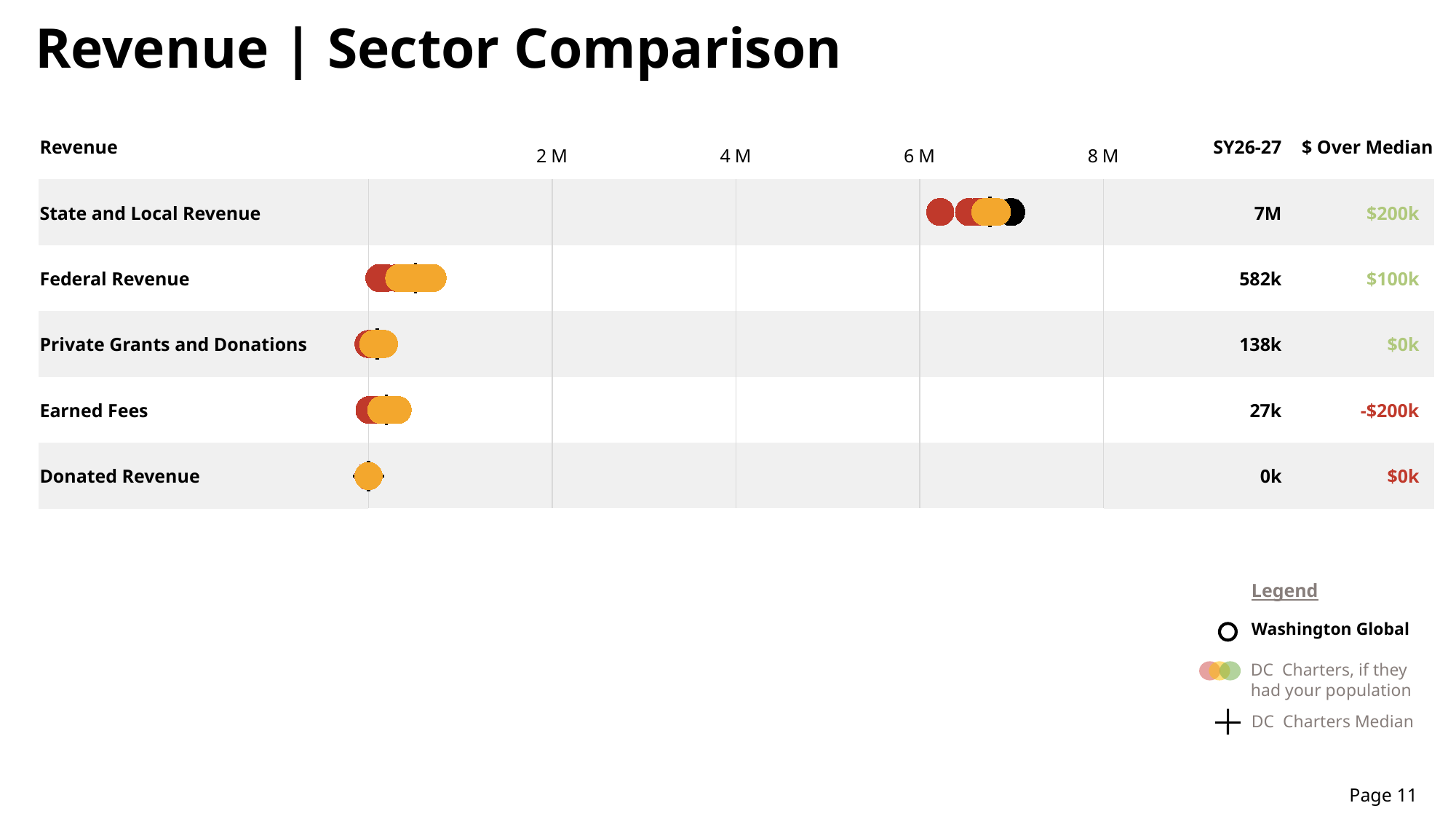
Is the value for State and Local Revenue greater or less than 6 M? greater What is the SY26-27 value for Private Grants and Donations? 138k What is the $ Over Median value for State and Local Revenue? $200k How many entries does the legend list? 3 Which revenue category has the highest SY26-27 value? State and Local Revenue What is the $ Over Median value for Earned Fees? -$200k What is the SY26-27 value for State and Local Revenue? 7M Which is larger, the SY26-27 value for Federal Revenue or for Earned Fees? Federal Revenue How many revenue categories are shown in the chart? 5 Which revenue category has the lowest SY26-27 value? Donated Revenue What is the title of the slide? Revenue | Sector Comparison What is the SY26-27 value for Federal Revenue? 582k